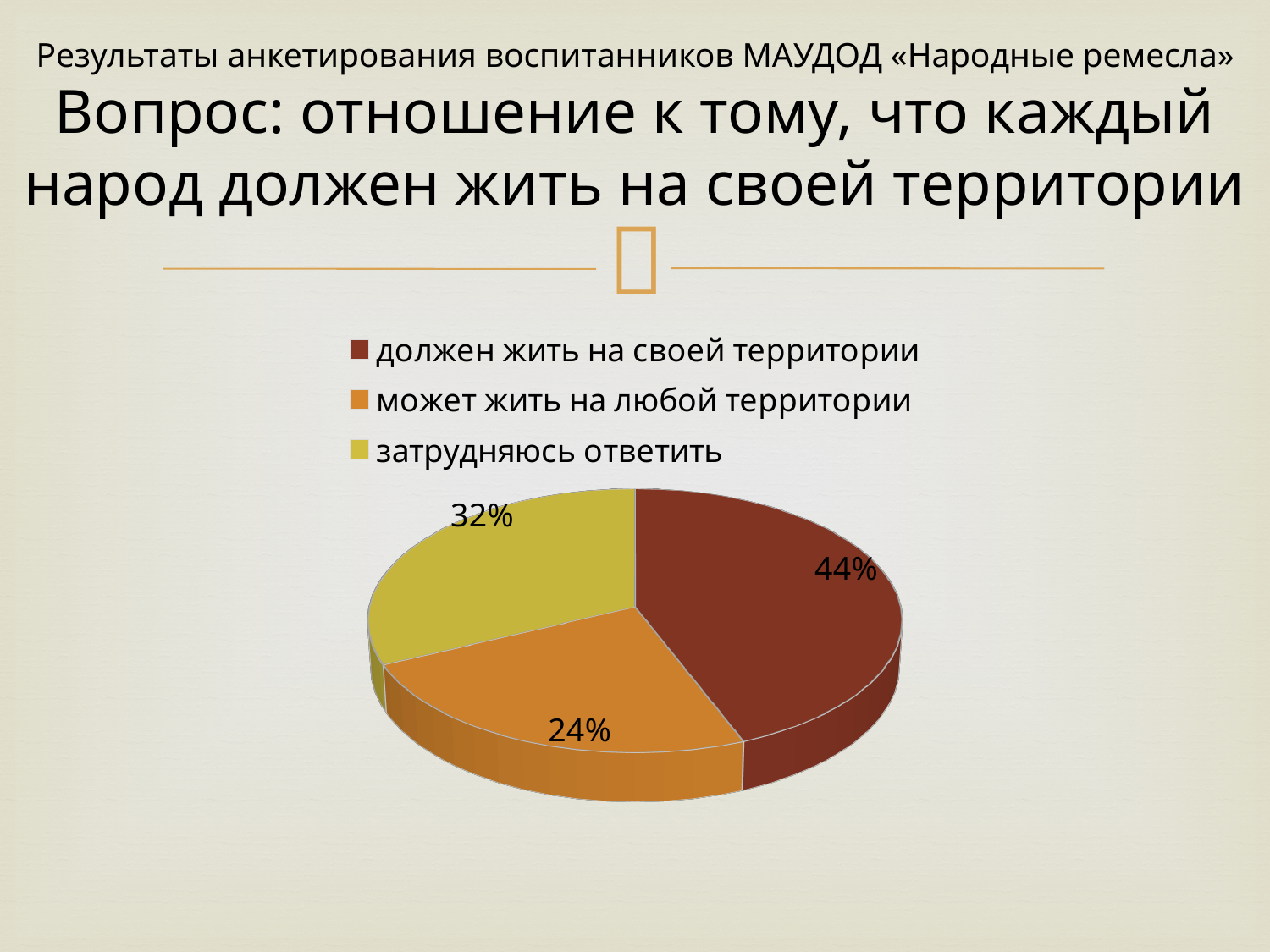
What is the difference in percentage points between «затрудняюсь ответить» and «может жить на любой территории»? 8 Which answer option has the smallest share of the pie? может жить на любой территории What share of respondents answered «должен жить на своей территории»? 44% What kind of chart is shown on the slide? pie chart What colour is the slice for «затрудняюсь ответить»? yellow-green What share of respondents answered «затрудняюсь ответить»? 32% How many entries does the legend list? 3 How many slices does the pie chart have? 3 What is the difference in percentage points between «должен жить на своей территории» and «может жить на любой территории»? 20 Which answer option has the largest share of the pie? должен жить на своей территории What share of respondents answered «может жить на любой территории»? 24% Which is larger: the share for «затрудняюсь ответить» or the share for «может жить на любой территории»? затрудняюсь ответить